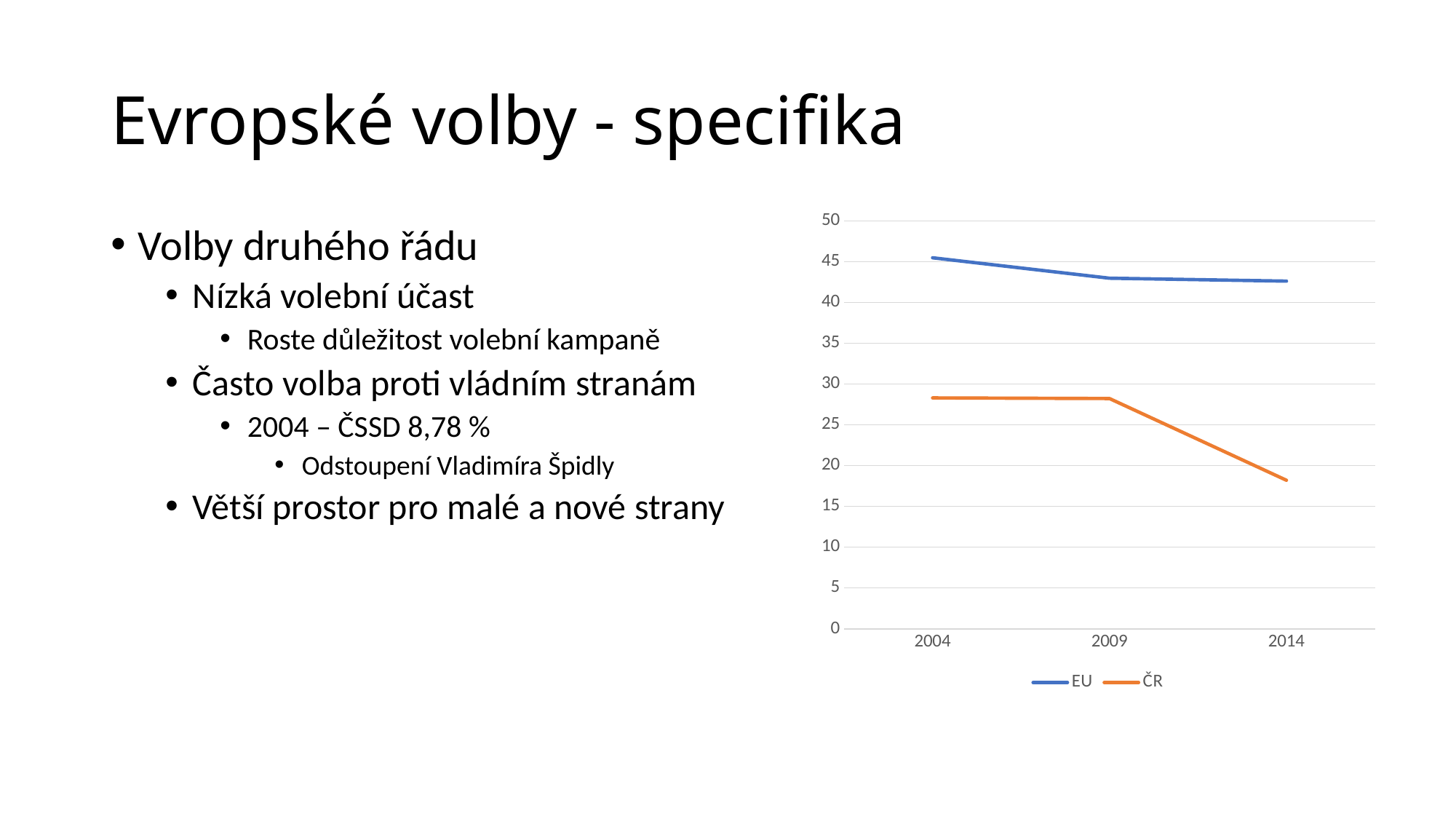
What kind of chart is shown on the slide? line chart Which series has the larger value in 2014, EU or ČR? EU Does the EU line rise or fall from 2004 to 2014? fall How many years are shown on the x axis of the chart? 3 In which year is the EU value highest? 2004 Is the ČR value for 2014 greater or less than 20? less In which year is the ČR value lowest? 2014 Does the ČR line rise or fall between 2009 and 2014? fall How many series does the chart's legend list? 2 Which series is shown in orange in the chart? ČR What are the two series named in the chart's legend? EU and ČR